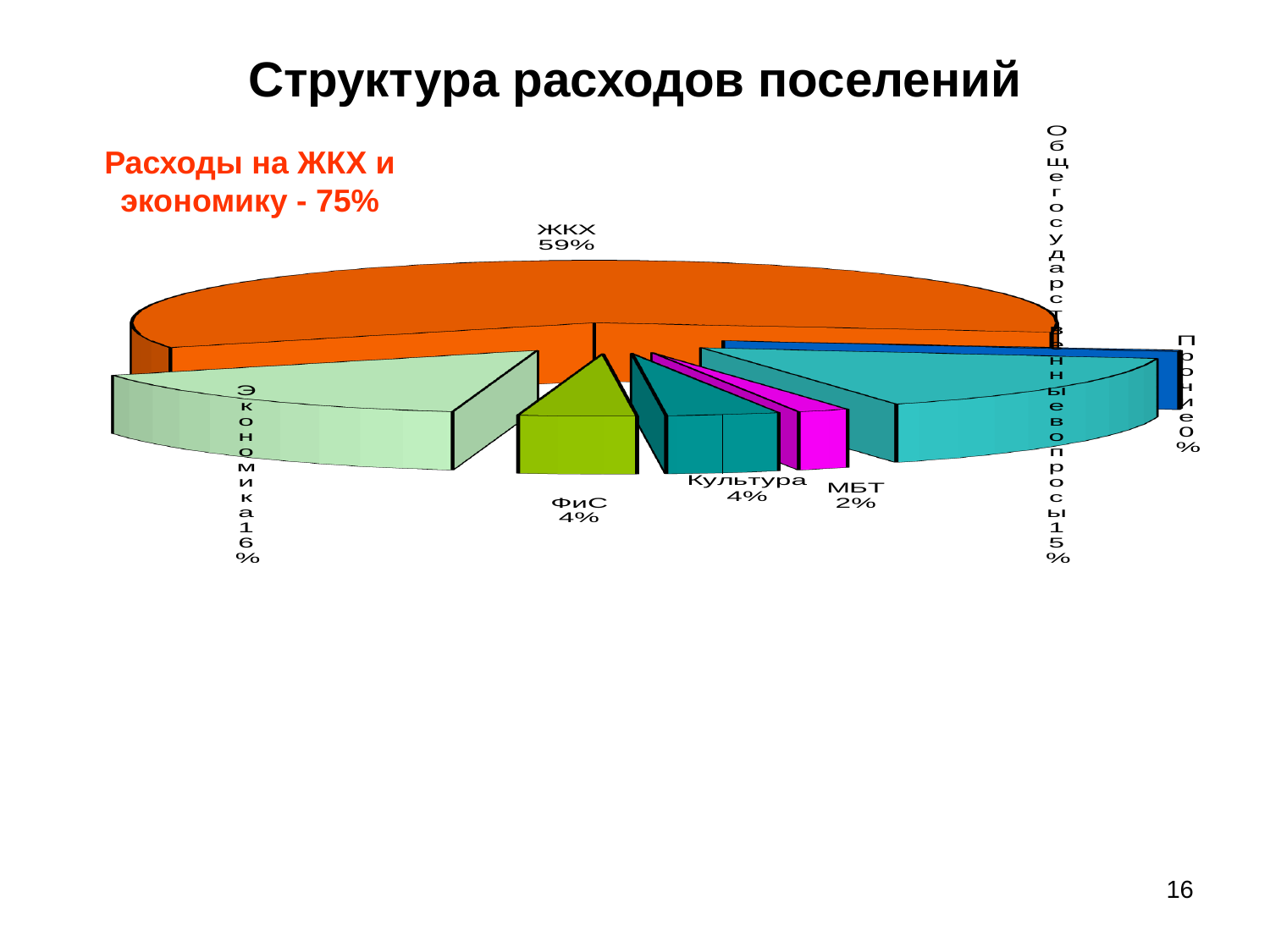
What percentage is shown for Экономика? 16% Which is larger, the share for Экономика or the share for Общегосударственные вопросы? Экономика What is the difference in percentage points between ЖКХ and Экономика? 43 What percentage is shown for Прочие? 0% What is the title of the slide containing the chart? Структура расходов поселений What percentage is shown for Общегосударственные вопросы? 15% What type of chart is shown on the slide? pie chart What share of expenditures does ЖКХ account for? 59% How many categories are shown in the pie chart? 7 What percentage is shown for МБТ? 2% Which category has the largest share of the pie? ЖКХ Which category has the smallest share of the pie? Прочие